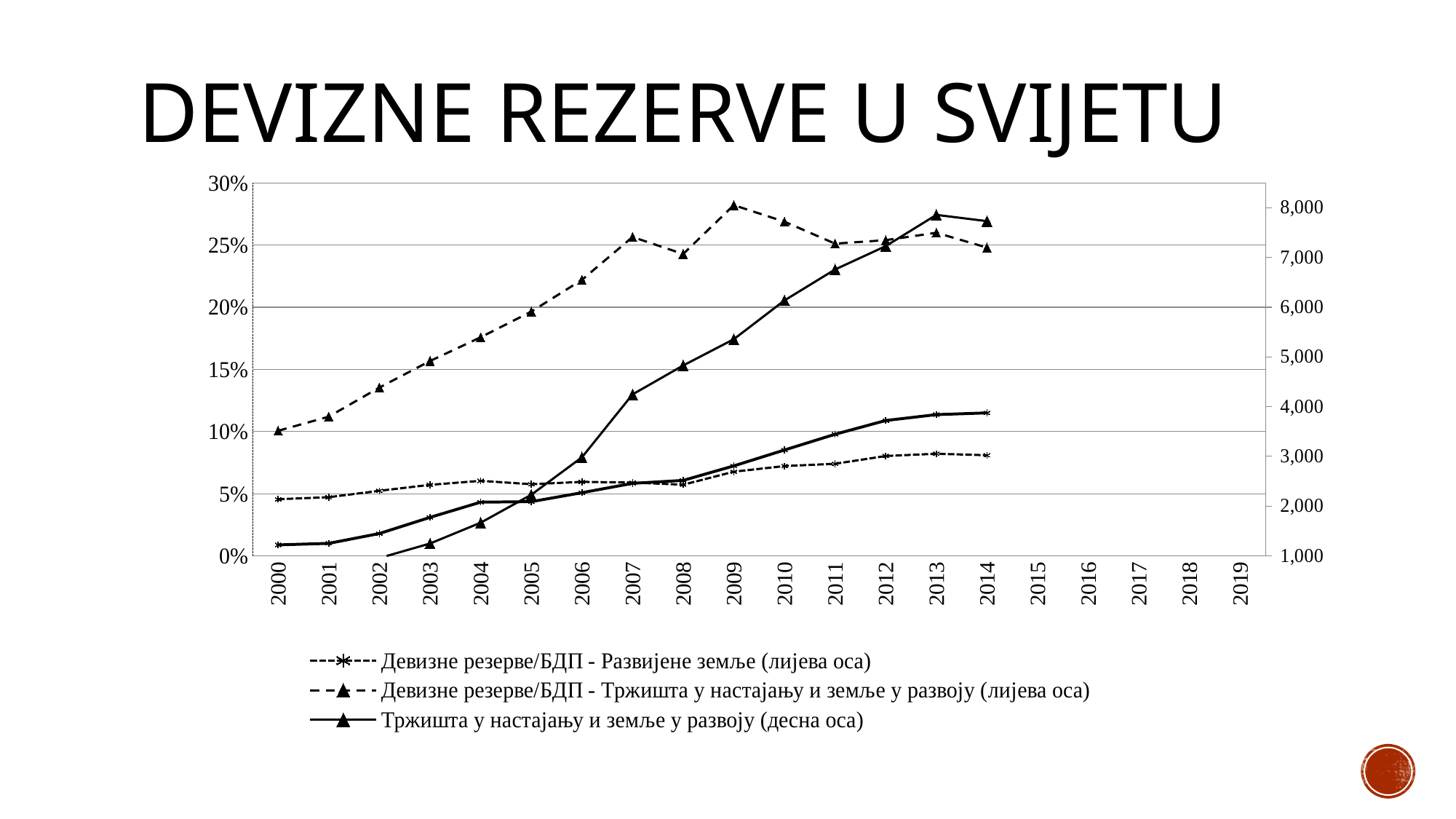
Is the value for 2013 of the series 'Тржишта у настајању и земље у развоју (десна оса)' greater or less than 7,000? greater What is the title of the slide containing the chart? DEVIZNE REZERVE U SVIJETU Is the value for 2009 of the series 'Девизне резерве/БДП - Тржишта у настајању и земље у развоју (лијева оса)' greater or less than 25%? greater Is the value for 2000 of the series 'Девизне резерве/БДП - Тржишта у настајању и земље у развоју (лијева оса)' greater or less than 15%? less In which year does the series 'Девизне резерве/БДП - Тржишта у настајању и земље у развоју (лијева оса)' reach its highest value? 2009 How many series does the legend list? 3 How many year labels are shown on the x axis? 20 What is the last year on the x axis for which data points are plotted? 2014 What kind of chart is shown on the slide? line chart Does the series 'Тржишта у настајању и земље у развоју (десна оса)' rise or fall from 2002 to 2013? rise